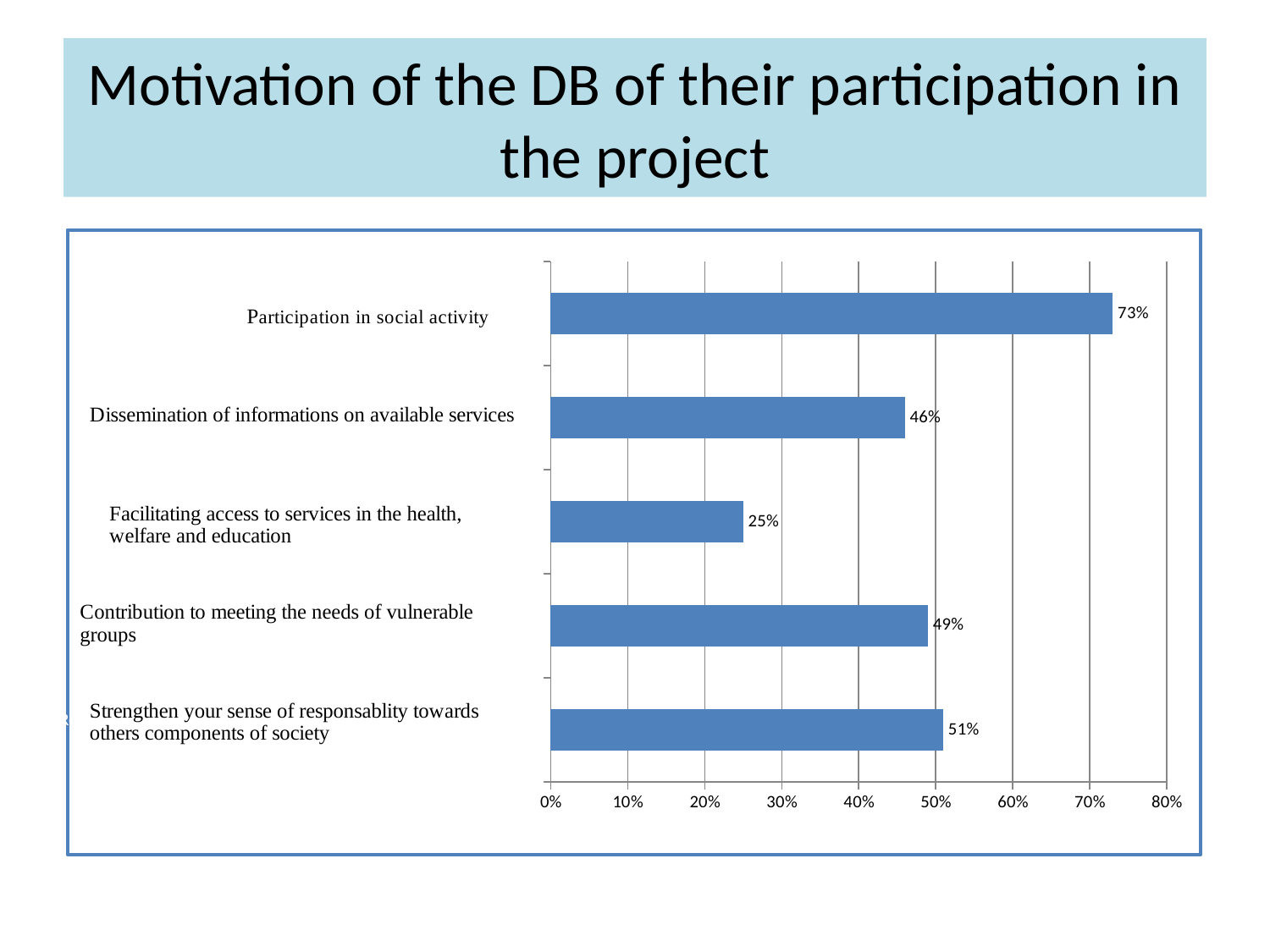
Which category has the lowest value? Facilitating access to services in the health, welfare and education What is the title of the slide? Motivation of the DB of their participation in the project Which category has the highest value? Participation in social activity What is the value for Strengthen your sense of responsablity towards others components of society? 51% How many categories are shown in the chart? 5 What is the value for Participation in social activity? 73% What kind of chart is shown on the slide? Bar chart What is the value for Contribution to meeting the needs of vulnerable groups? 49% What is the value for Facilitating access to services in the health, welfare and education? 25% What is the difference between the values for Participation in social activity and Facilitating access to services in the health, welfare and education? 48% What is the value for Dissemination of informations on available services? 46% Which is larger: the value for Dissemination of informations on available services or the value for Contribution to meeting the needs of vulnerable groups? Contribution to meeting the needs of vulnerable groups